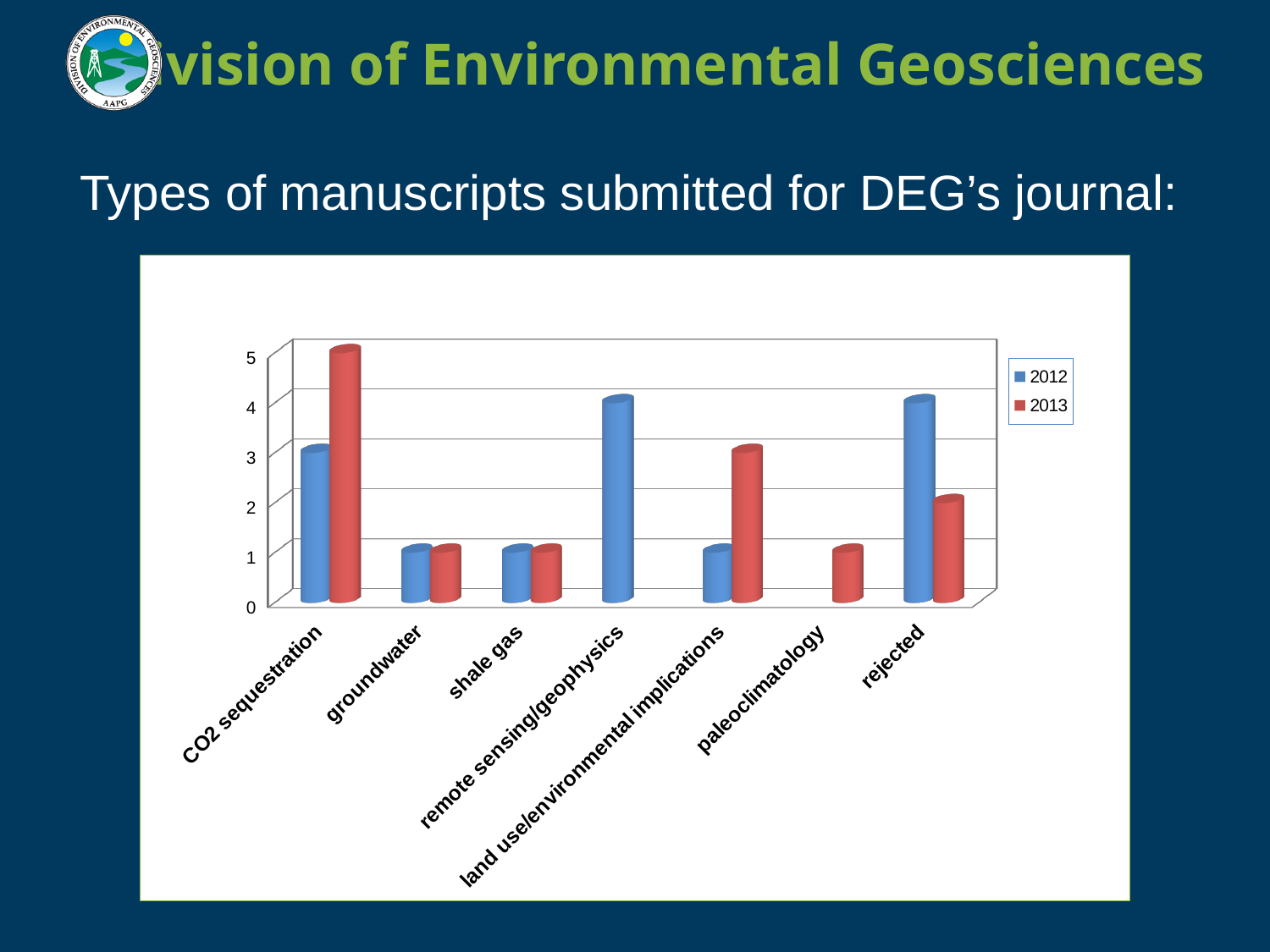
Which category has the highest 2013 value? CO2 sequestration Is the 2012 value for rejected greater or less than 3? greater What is the 2013 value for land use/environmental implications? 3 What is the difference between the 2013 and 2012 values for CO2 sequestration? 2 Which is larger for rejected manuscripts, the 2012 value or the 2013 value? 2012 How many categories are shown on the x axis? 7 How many series does the legend list? 2 What is the 2012 value for remote sensing/geophysics? 4 What is the 2013 value for CO2 sequestration? 5 What is the 2012 value for CO2 sequestration? 3 Which series is shown in red in the legend? 2013 What kind of chart is shown on the slide? bar chart